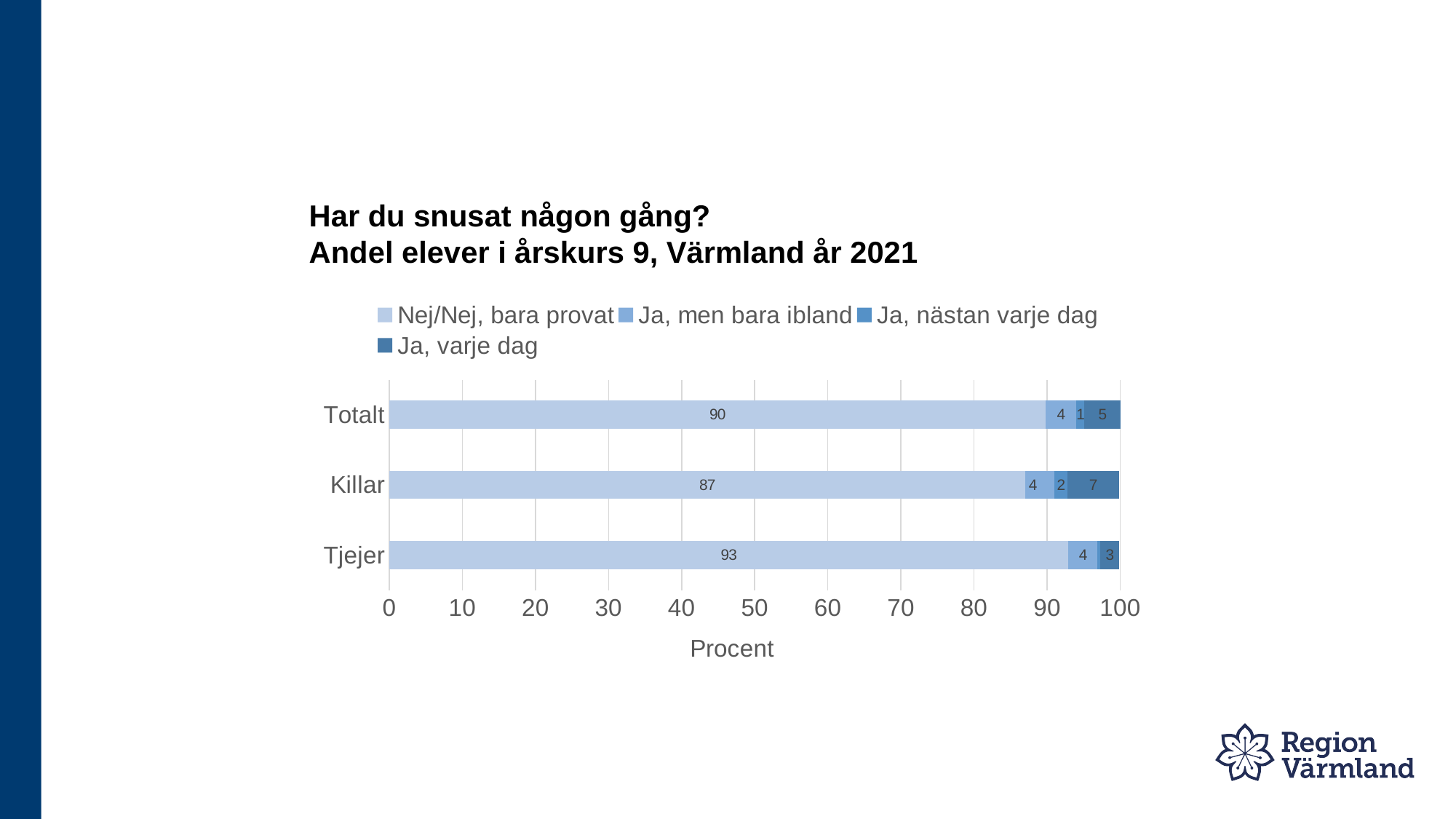
What is the value for "Ja, varje dag" for Totalt? 5 What is the value for "Ja, nästan varje dag" for Killar? 2 What is the value for "Nej/Nej, bara provat" for Tjejer? 93 How many series does the legend list? 4 Which category has the highest value for "Nej/Nej, bara provat"? Tjejer What is the difference between the "Ja, varje dag" values for Killar and Tjejer? 4 What is the label of the horizontal axis? Procent Which category has the lowest value for "Ja, varje dag"? Tjejer What kind of chart is shown on the slide? Stacked bar chart How many categories are shown on the vertical axis? 3 Which is larger, the "Nej/Nej, bara provat" value for Totalt or for Killar? Totalt What is the value for "Nej/Nej, bara provat" for Killar? 87